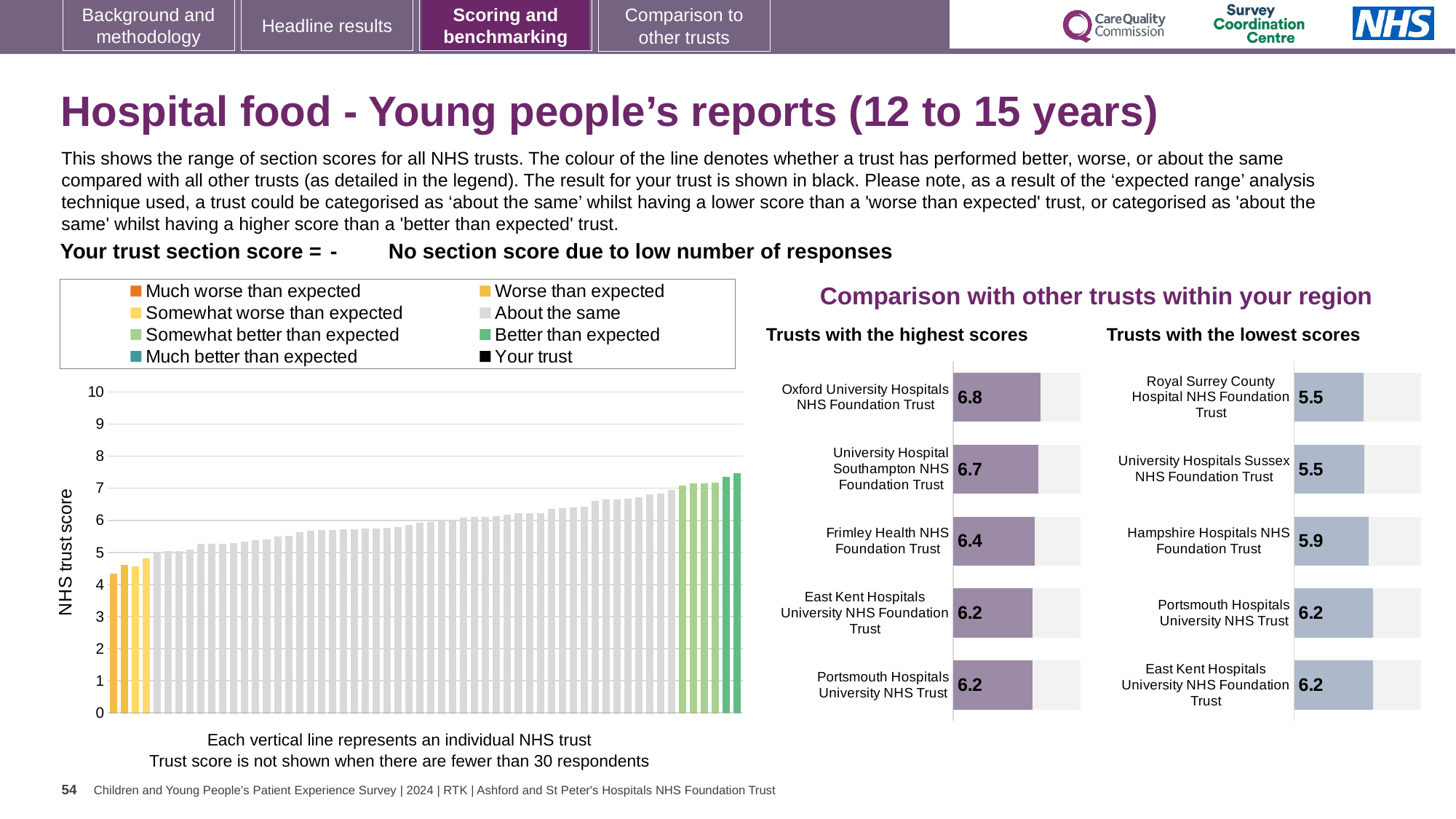
In the left-hand chart of NHS trust scores, is the value of the shortest bar greater or less than 5? less In the 'Trusts with the lowest scores' chart, what is the score for Royal Surrey County Hospital NHS Foundation Trust? 5.5 In the 'Trusts with the highest scores' chart, what is the score for Oxford University Hospitals NHS Foundation Trust? 6.8 In the 'Trusts with the lowest scores' chart, what is the difference between the scores of Portsmouth Hospitals University NHS Trust and Royal Surrey County Hospital NHS Foundation Trust? 0.7 In the 'Trusts with the highest scores' chart, what is the difference between the scores of Oxford University Hospitals NHS Foundation Trust and University Hospital Southampton NHS Foundation Trust? 0.1 How many trusts are shown in the 'Trusts with the lowest scores' chart? 5 In the 'Trusts with the highest scores' chart, what is the score for Frimley Health NHS Foundation Trust? 6.4 In the 'Trusts with the lowest scores' chart, what is the score for Hampshire Hospitals NHS Foundation Trust? 5.9 In the 'Trusts with the highest scores' chart, which has the larger score: University Hospital Southampton NHS Foundation Trust or Frimley Health NHS Foundation Trust? University Hospital Southampton NHS Foundation Trust In the left-hand chart of NHS trust scores, is the value of the tallest bar greater or less than 7? greater In the 'Trusts with the highest scores' chart, which trust has the highest score? Oxford University Hospitals NHS Foundation Trust How many entries does the legend of the left-hand chart list? 8